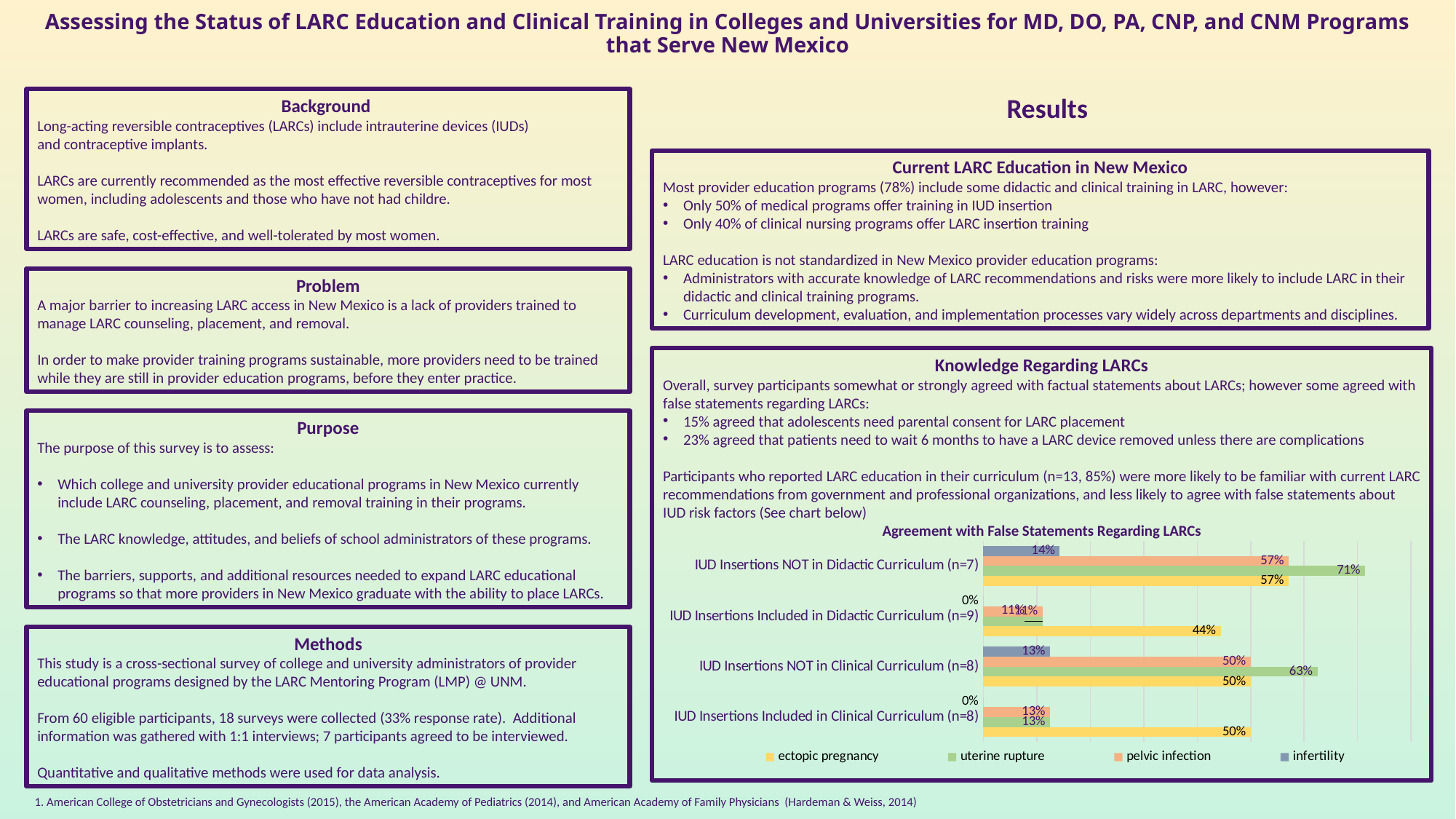
What is the infertility value for IUD Insertions NOT in Clinical Curriculum (n=8)? 13% Which category has the highest uterine rupture value? IUD Insertions NOT in Didactic Curriculum (n=7) What is the pelvic infection value for IUD Insertions Included in Clinical Curriculum (n=8)? 13% What is the ectopic pregnancy value for IUD Insertions Included in Didactic Curriculum (n=9)? 44% How many series does the legend of the chart list? 4 What is the title of the chart on the slide? Agreement with False Statements Regarding LARCs What is the infertility value for IUD Insertions Included in Clinical Curriculum (n=8)? 0% What kind of chart is shown under "Agreement with False Statements Regarding LARCs"? bar chart Which is larger: the uterine rupture value for IUD Insertions NOT in Clinical Curriculum (n=8) or the ectopic pregnancy value for the same category? uterine rupture What is the difference between the ectopic pregnancy values for IUD Insertions NOT in Didactic Curriculum (n=7) and IUD Insertions Included in Didactic Curriculum (n=9)? 13% How many categories are shown on the chart? 4 What is the uterine rupture value for IUD Insertions NOT in Didactic Curriculum (n=7)? 71%